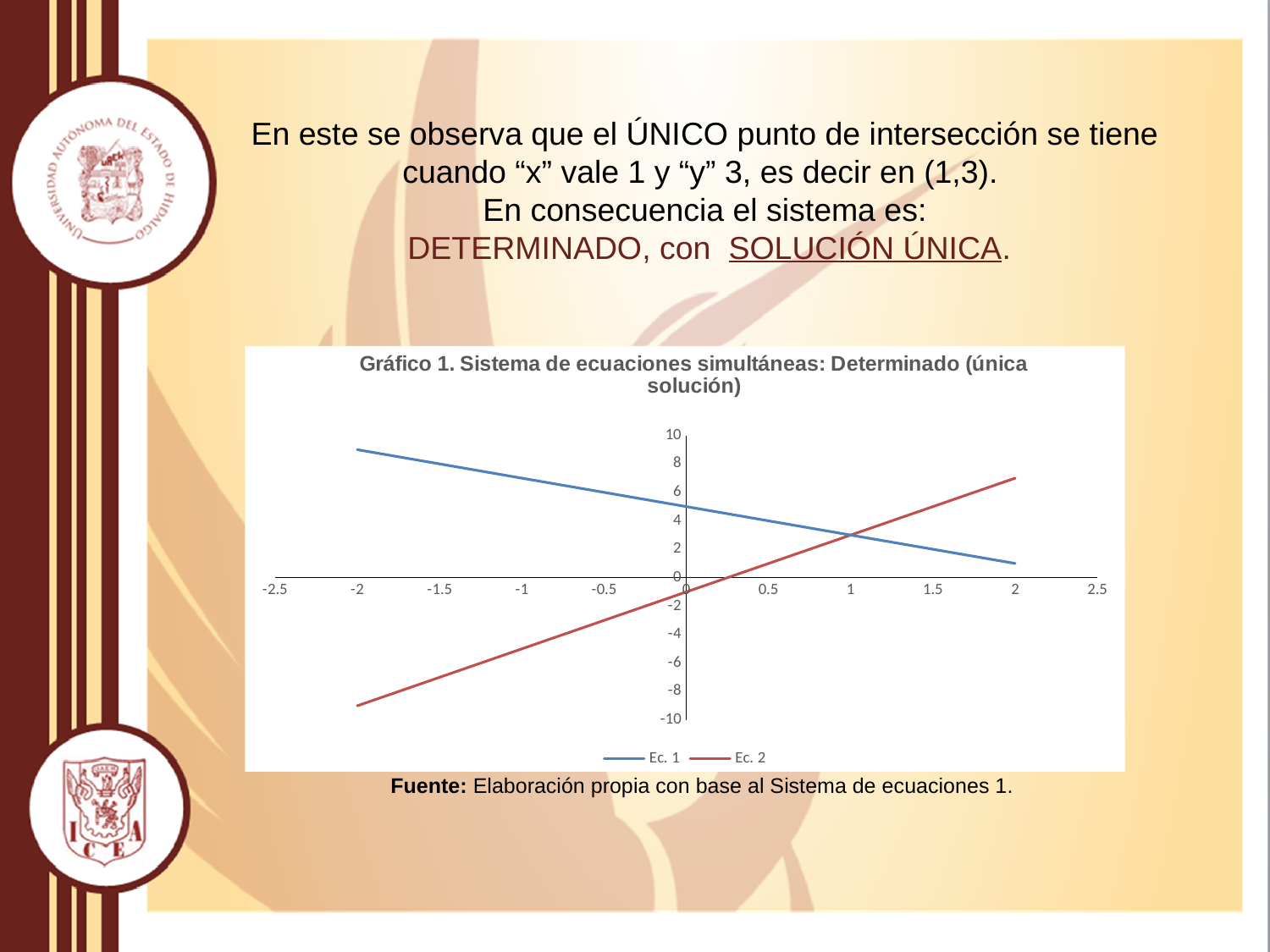
At x = 2, is the value of Ec. 1 greater or less than 2? less At x = -2, which series has the higher value, Ec. 1 or Ec. 2? Ec. 1 How many series does the legend of the chart list? 2 At x = 2, is the value of Ec. 2 greater or less than 6? greater What kind of chart is shown on the slide? line chart Does the line for Ec. 1 rise or fall as x increases? fall At x = -2, is the value of Ec. 2 greater or less than -8? less What colour is the line for Ec. 2 in the chart? red What are the two series named in the chart legend? Ec. 1 and Ec. 2 At x = 2, which series has the higher value, Ec. 1 or Ec. 2? Ec. 2 Does the line for Ec. 2 rise or fall as x increases? rise